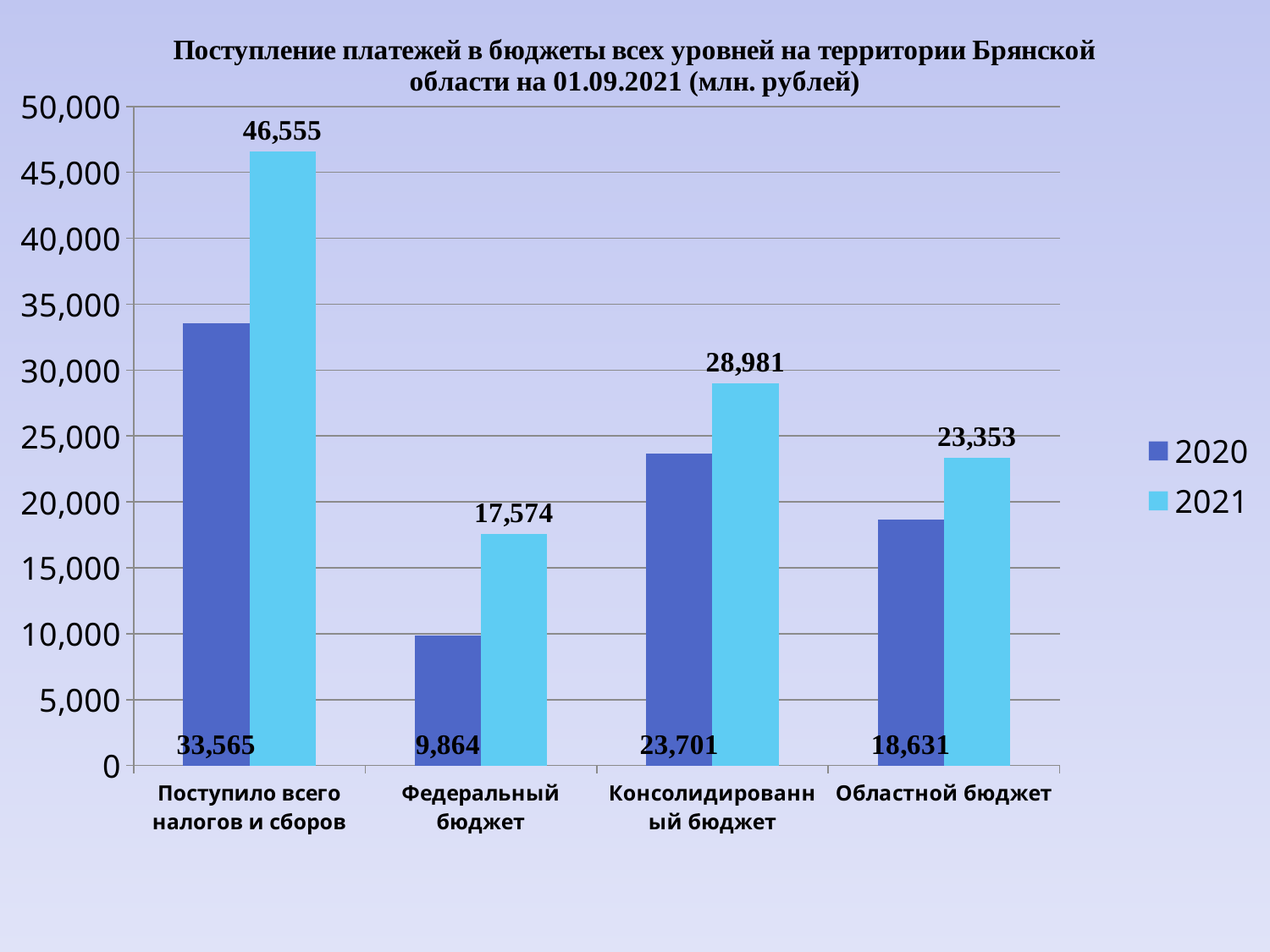
What is the 2020 value for Областной бюджет? 18,631 How many series does the legend list? 2 What is the difference between the 2021 and 2020 values for Поступило всего налогов и сборов? 12,990 What is the 2020 value for Федеральный бюджет? 9,864 How many categories are shown on the x axis? 4 Which category has the lowest 2020 value? Федеральный бюджет What is the 2021 value for Консолидированный бюджет? 28,981 What is the 2021 value for Поступило всего налогов и сборов? 46,555 Which is larger for Областной бюджет: the 2020 value or the 2021 value? 2021 What kind of chart is shown on the slide? Bar chart What is the difference between the 2021 and 2020 values for Федеральный бюджет? 7,710 Which category has the highest 2021 value? Поступило всего налогов и сборов